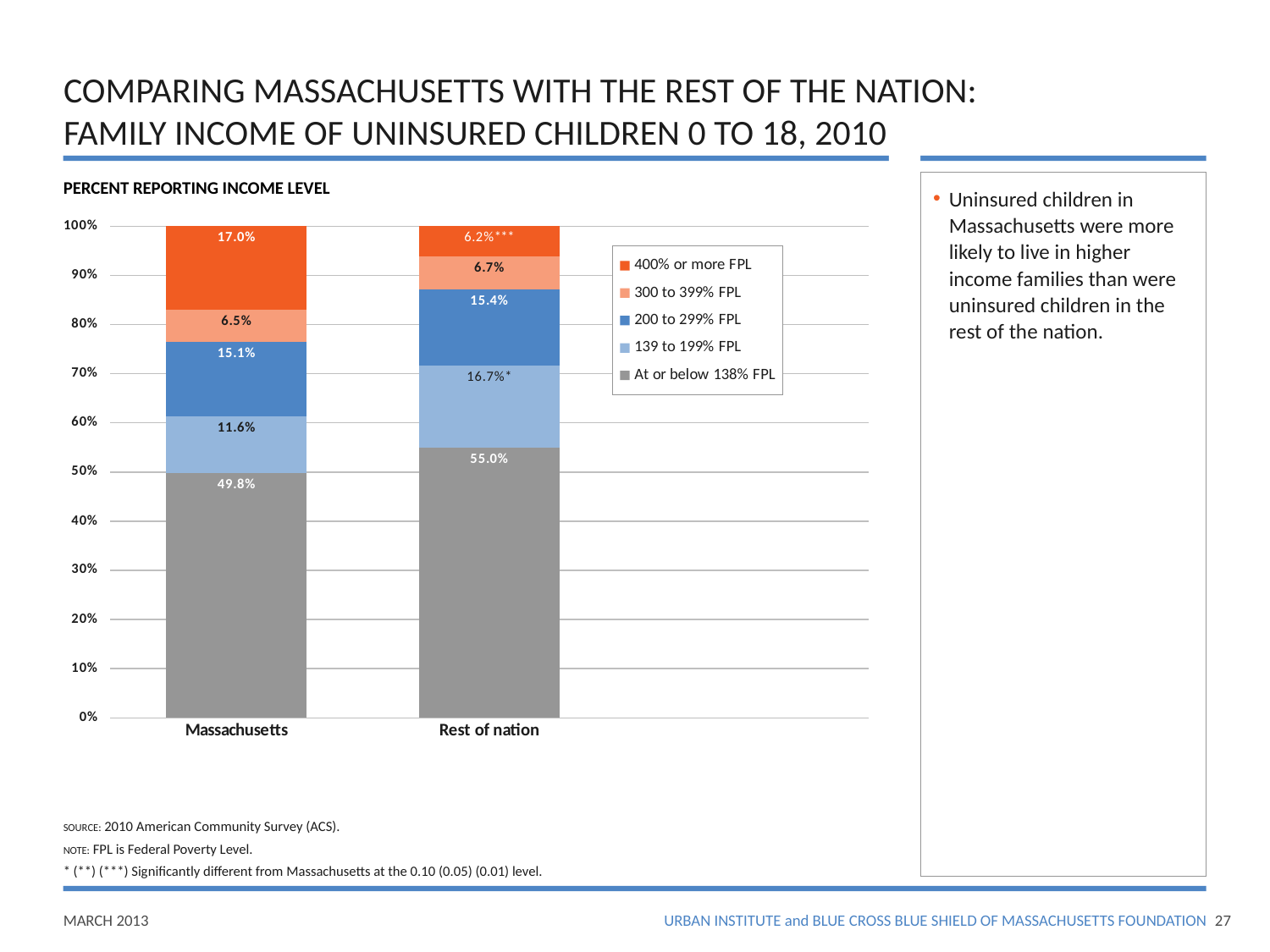
What percentage of uninsured children in the rest of the nation are in families with 400% or more FPL? 6.2% What is the value for the 139 to 199% FPL segment for the rest of nation? 16.7% What percentage of uninsured children in Massachusetts are in families at or below 138% FPL? 49.8% Which income level segment is the largest for the rest of nation bar? At or below 138% FPL What is the difference between the 400% or more FPL values for Massachusetts and the rest of nation? 10.8 percentage points Which category has the larger share of uninsured children in families with 400% or more FPL, Massachusetts or Rest of nation? Massachusetts How many series does the legend list? 5 What type of chart is shown on the slide? Stacked bar chart What is the difference between the at or below 138% FPL values for the rest of nation and Massachusetts? 5.2 percentage points How many categories are shown on the x axis? 2 What is the value for the 300 to 399% FPL segment for Massachusetts? 6.5% Which income level segment is the smallest for the Massachusetts bar? 300 to 399% FPL